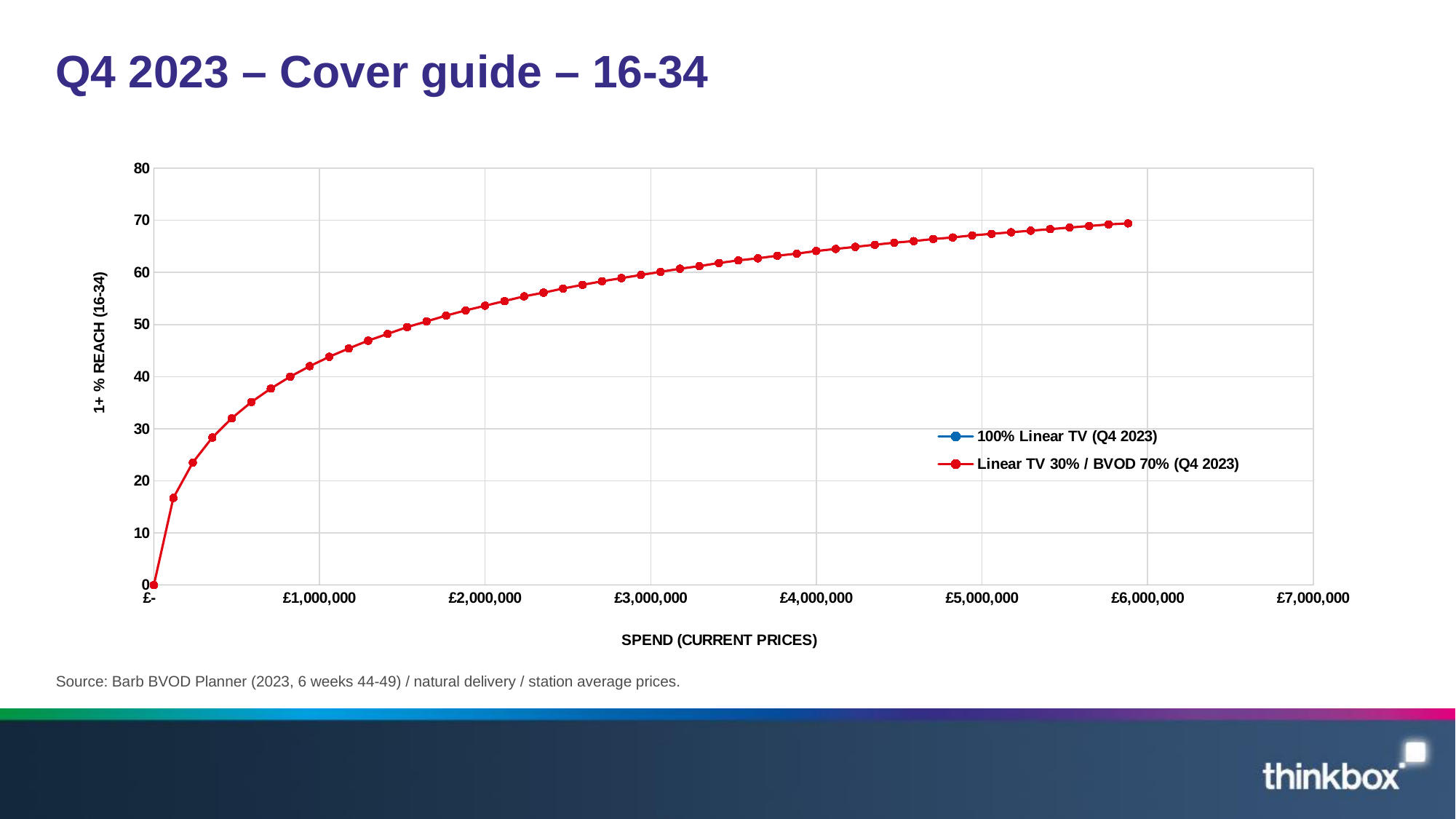
Is the 1+ % reach at a spend of £2,000,000 greater or less than 50? greater Is the 1+ % reach at a spend of £4,000,000 greater or less than 60? greater Is the 1+ % reach at a spend of £1,000,000 greater or less than 40? greater What is the 1+ % reach at a spend of £- (zero spend)? 0 Is the 1+ % reach at a spend of £1,000,000 larger or smaller than at £5,000,000? Smaller How many series does the legend list? 2 What kind of chart is shown on the slide? Line chart What is the title of the x axis? SPEND (CURRENT PRICES) Does the 1+ % reach rise or fall as spend increases along the x axis? Rises What is the second series listed in the legend? Linear TV 30% / BVOD 70% (Q4 2023)